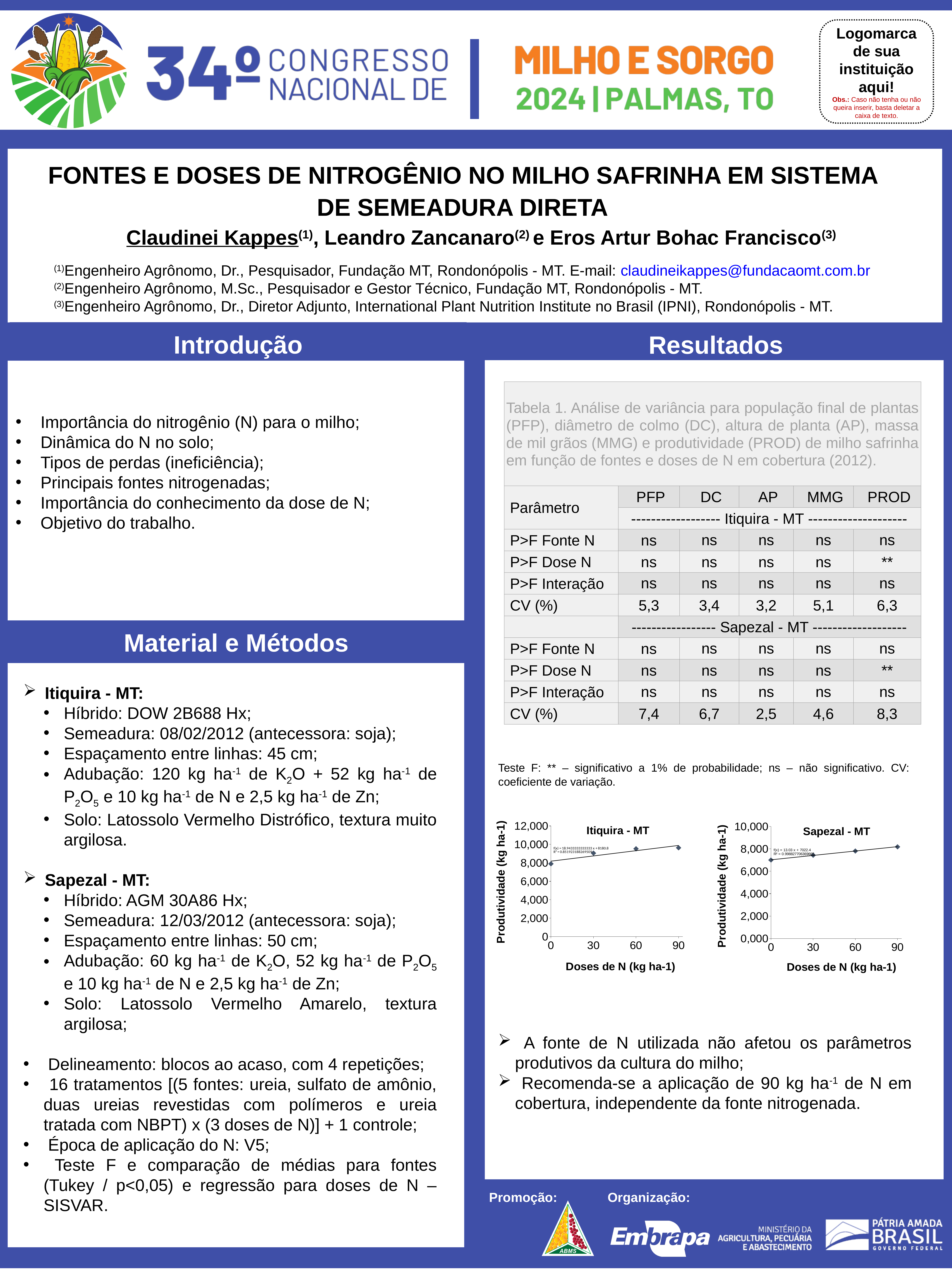
In the "Itiquira - MT" chart, is the productivity at a dose of 0 greater or less than 10,000? less In the "Itiquira - MT" chart, is the productivity at a dose of 90 greater or less than 8,000? greater In the "Sapezal - MT" chart, is the productivity at a dose of 90 greater or less than 6,000? greater What kind of chart is the "Itiquira - MT" chart? scatter chart with a trend line What is the x-axis title of the "Itiquira - MT" chart? Doses de N (kg ha-1) In the "Sapezal - MT" chart, which has the larger productivity: the dose of 0 or the dose of 90? 90 In the "Itiquira - MT" chart, do the productivity values rise or fall as the N dose increases along the x axis? rise In the "Sapezal - MT" chart, do the productivity values rise or fall as the N dose increases along the x axis? rise In the "Sapezal - MT" chart, which N dose has the highest productivity? 90 In the "Itiquira - MT" chart, which N dose has the lowest productivity? 0 How many data points are plotted in the "Sapezal - MT" chart? 4